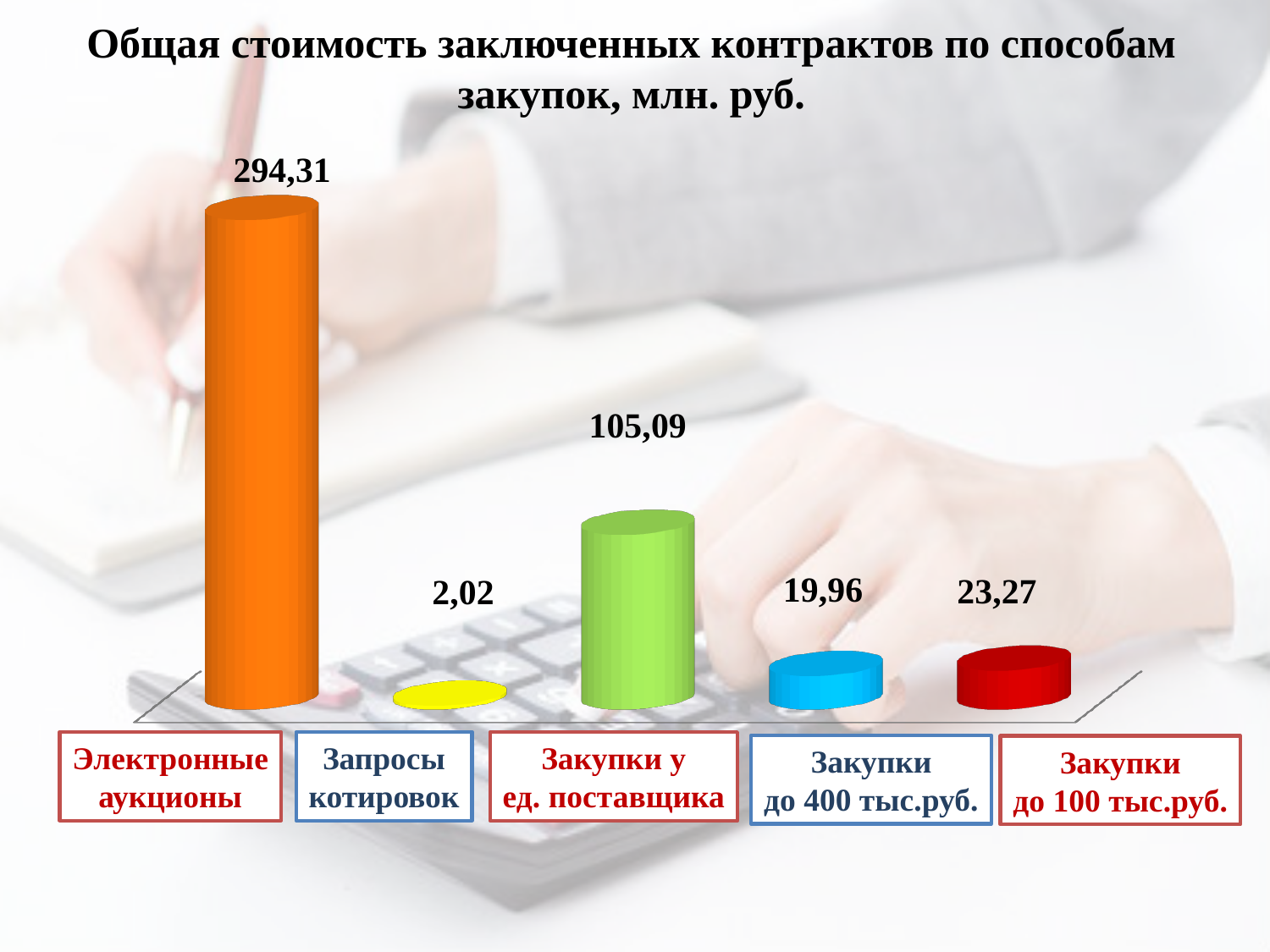
Which category has the lowest value? Запросы котировок What is the value for Закупки у ед. поставщика? 105,09 What is the value for Закупки до 100 тыс.руб.? 23,27 What type of chart is shown on the slide? Bar chart How many categories are shown in the chart? 5 What is the difference between the values for Электронные аукционы and Закупки у ед. поставщика? 189,22 What is the value for Электронные аукционы? 294,31 Which category has the highest value? Электронные аукционы What is the value for Запросы котировок? 2,02 What is the difference between the values for Закупки до 100 тыс.руб. and Закупки до 400 тыс.руб.? 3,31 What is the value for Закупки до 400 тыс.руб.? 19,96 Which is larger: the value for Закупки до 400 тыс.руб. or Закупки до 100 тыс.руб.? Закупки до 100 тыс.руб.